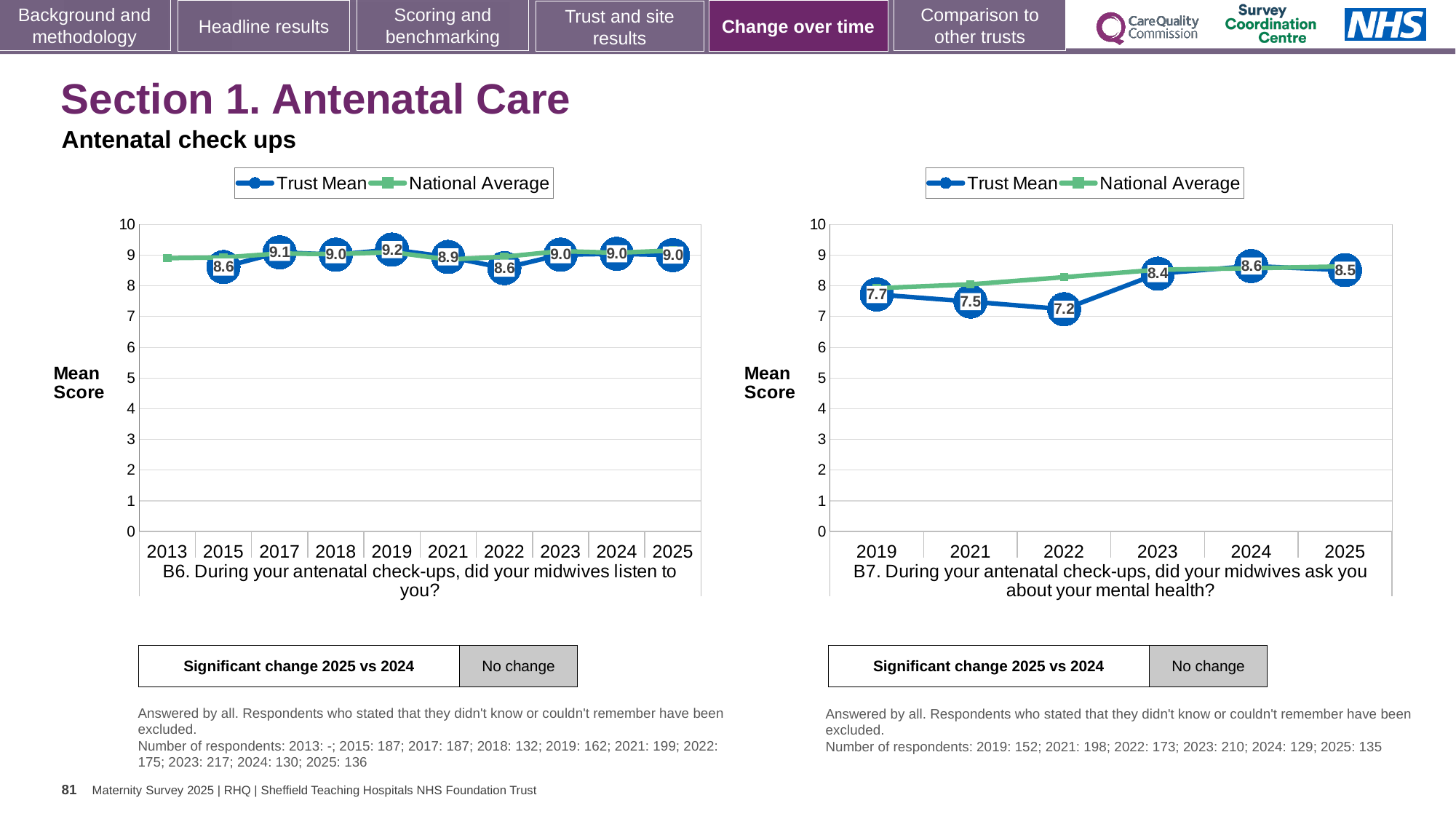
In the B7 chart (right), which year has the highest Trust Mean? 2024 In the B7 chart (right), which year has the lowest Trust Mean? 2022 In the B6 chart (left), which year has the highest Trust Mean? 2019 How many series does the legend of the B6 chart (left) list? 2 In the B7 chart (right), what is the Trust Mean for 2022? 7.2 In the B7 chart (right), is the National Average for 2019 greater or less than 7? greater What type of chart is the B6 chart (left)? Line chart In the B7 chart (right), is the Trust Mean for 2021 higher or lower than for 2025? lower In the B6 chart (left), what is the Trust Mean for 2022? 8.6 In the B6 chart (left), what is the Trust Mean for 2019? 9.2 In the B7 chart (right), what is the difference between the Trust Mean for 2023 and for 2022? 1.2 How many years are shown on the x axis of the B7 chart (right)? 6